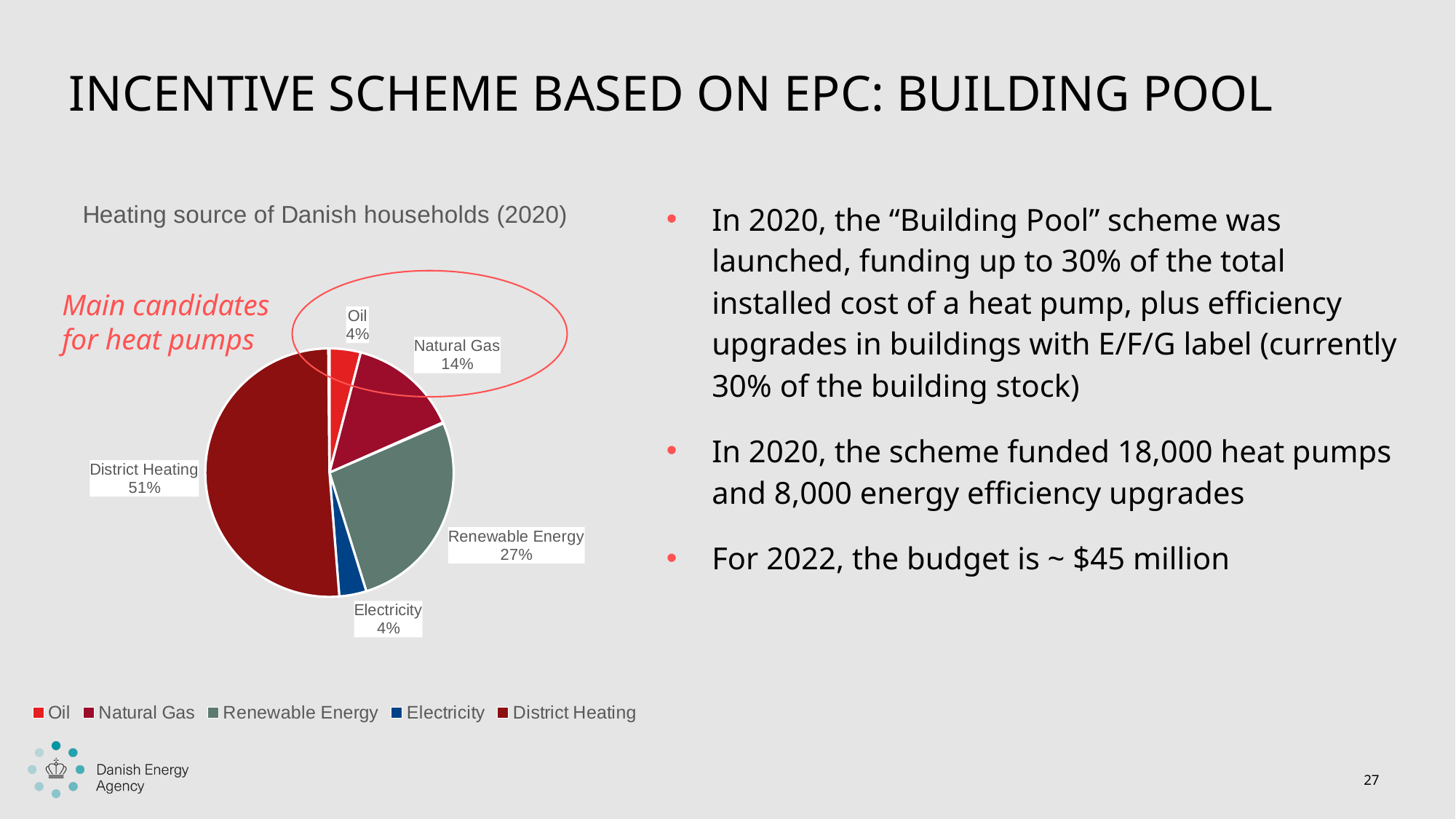
What is the title of the chart? Heating source of Danish households (2020) What share of Danish households use Renewable Energy as their heating source? 27% What kind of chart is shown on the slide? Pie chart Which has a larger share, Natural Gas or Renewable Energy? Renewable Energy Which two heating sources are circled as main candidates for heat pumps? Oil and Natural Gas How many entries does the legend list? 5 Which heating source has the largest share of Danish households? District Heating How many heating source categories are shown in the pie chart? 5 What is the difference in share between District Heating and Renewable Energy? 24 percentage points What share of Danish households use Natural Gas as their heating source? 14% What share of Danish households use Oil as their heating source? 4% What share of Danish households use District Heating as their heating source? 51%